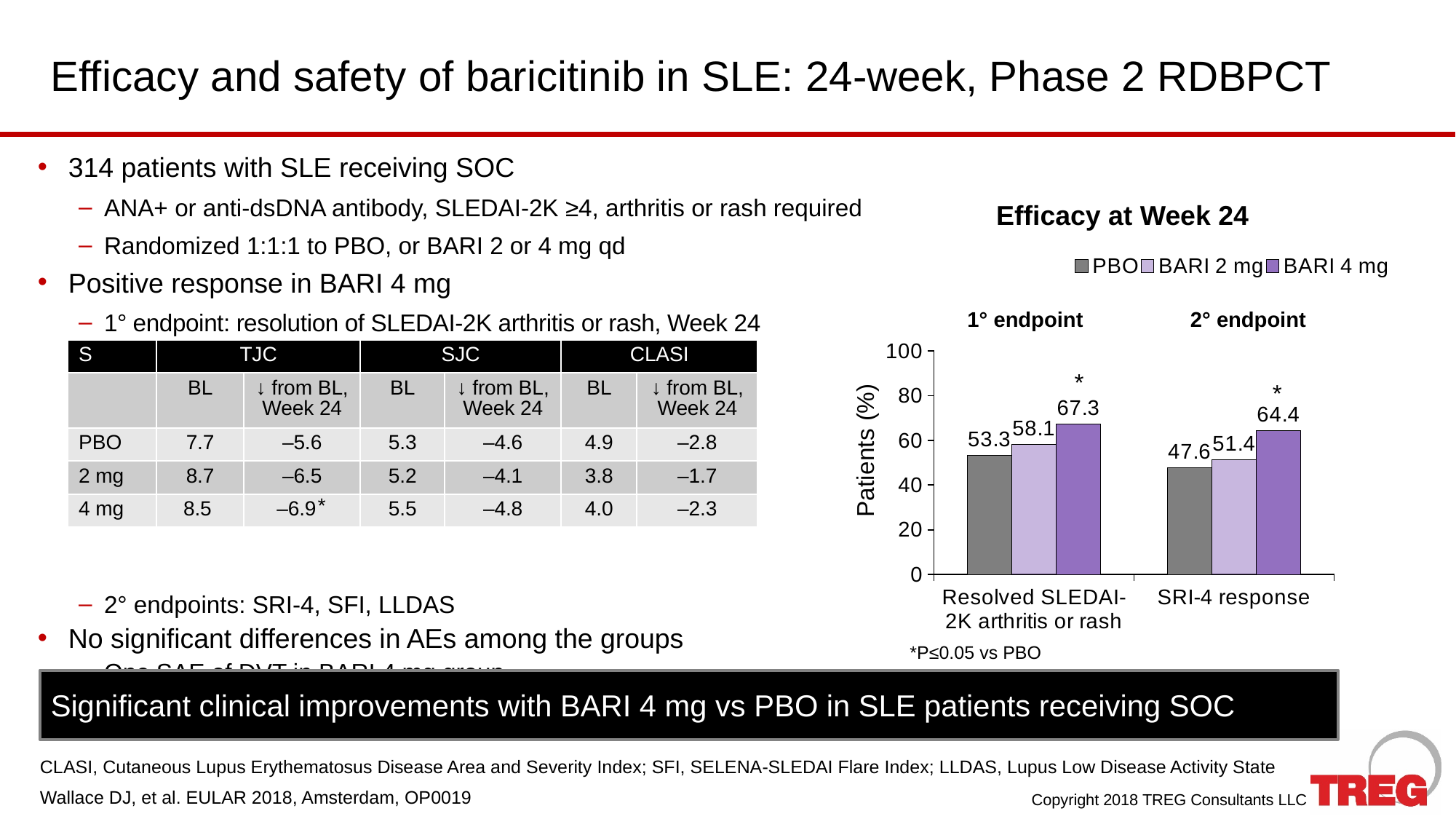
What is the title of the chart? Efficacy at Week 24 What kind of chart is shown on the slide? bar chart Which is larger: BARI 2 mg for Resolved SLEDAI-2K arthritis or rash, or BARI 2 mg for SRI-4 response? Resolved SLEDAI-2K arthritis or rash Which series has the highest value in the SRI-4 response category? BARI 4 mg What is the difference between BARI 4 mg and PBO in the Resolved SLEDAI-2K arthritis or rash category? 14.0 What is the value for BARI 4 mg in the Resolved SLEDAI-2K arthritis or rash category? 67.3 Which series has the lowest value in the Resolved SLEDAI-2K arthritis or rash category? PBO What is the value for PBO in the SRI-4 response category? 47.6 Is the value for PBO in the SRI-4 response category greater or less than 60? less What is the value for BARI 2 mg in the Resolved SLEDAI-2K arthritis or rash category? 58.1 How many series does the legend list? 3 What is the difference between BARI 4 mg and PBO in the SRI-4 response category? 16.8